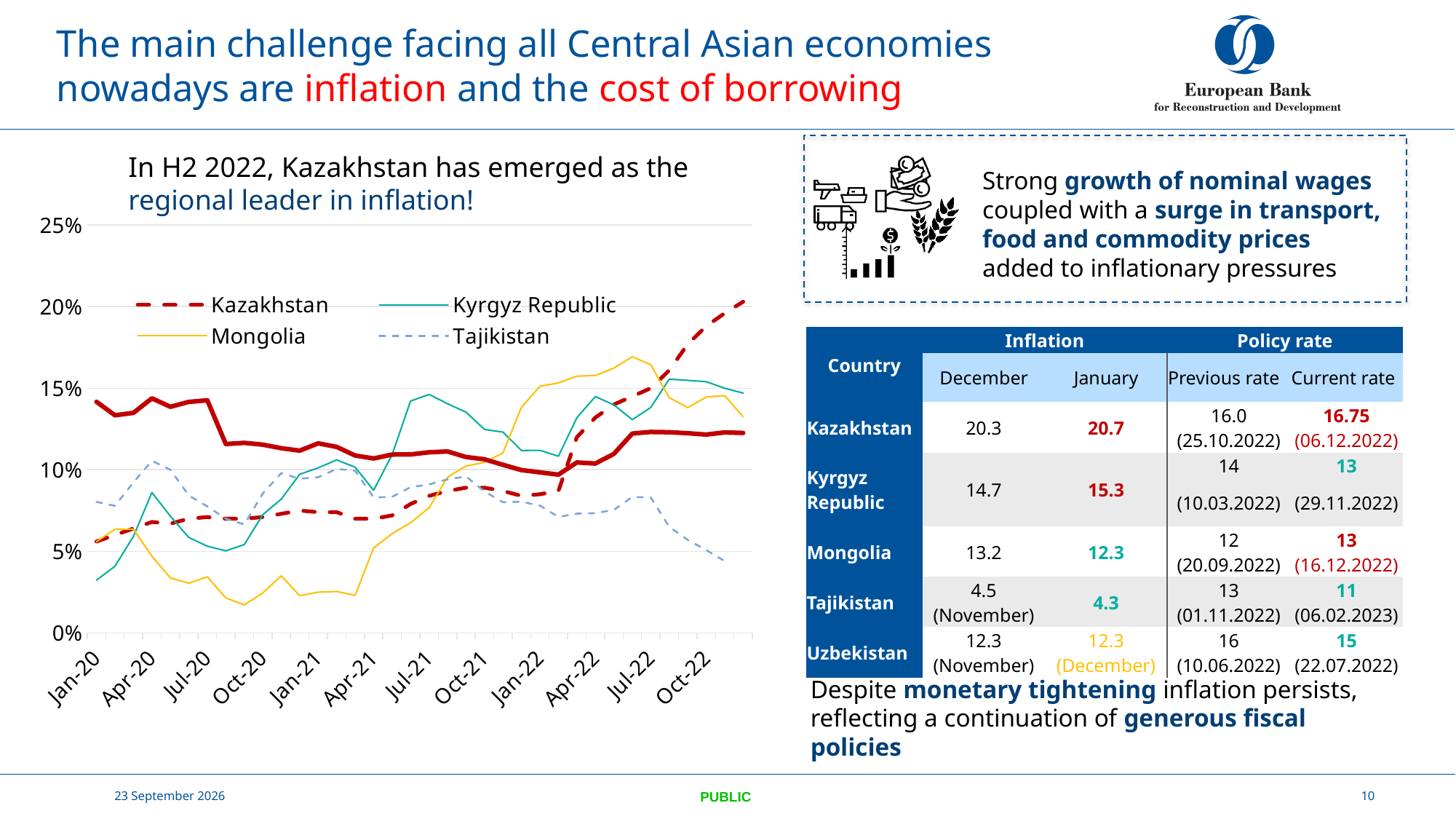
Is the value for Tajikistan at Jan-22 greater or less than 10%? less How many date labels are shown along the x axis of the line chart? 12 Is the value for Kazakhstan at Oct-22 greater or less than 15%? greater Is the value for Mongolia at Oct-20 greater or less than 5%? less How many series does the legend of the line chart list? 4 Which series has the lowest value at the end of the line chart? Tajikistan Which series has the highest value at the last point (Oct-22 onward) of the line chart? Kazakhstan At Jan-20, which series has the larger value, Kazakhstan or Kyrgyz Republic? Kazakhstan What is the highest value shown on the vertical axis of the line chart? 25% Which series is drawn as a thick red dashed line in the line chart? Kazakhstan Does the Kazakhstan line rise or fall between Jan-22 and Oct-22? rise What kind of chart is shown on the left of the slide? line chart